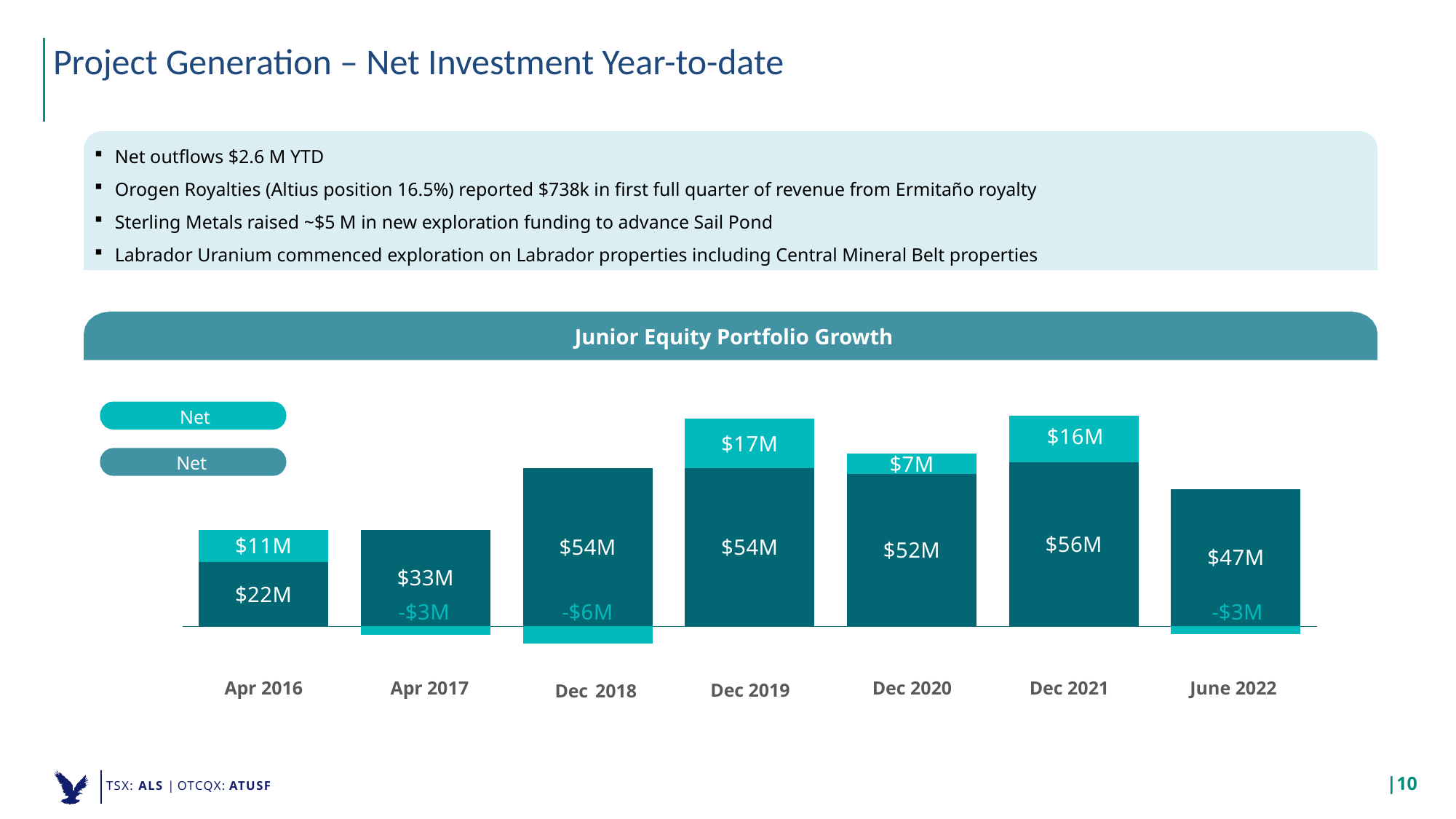
In the Junior Equity Portfolio Growth chart, what is the total of the two stacked segments for Dec 2019? $71M In the Junior Equity Portfolio Growth chart, is the light teal value larger for Dec 2019 or Dec 2021? Dec 2019 In the Junior Equity Portfolio Growth chart, what is the difference between the dark teal values for Dec 2021 and June 2022? $9M In the Junior Equity Portfolio Growth chart, what is the value of the light teal segment for Dec 2019? $17M In the Junior Equity Portfolio Growth chart, which period has the highest dark teal value? Dec 2021 How many series does the legend of the Junior Equity Portfolio Growth chart list? 2 In the Junior Equity Portfolio Growth chart, what is the value of the dark teal segment for Dec 2021? $56M What kind of chart is shown under the heading "Junior Equity Portfolio Growth"? Bar chart In the Junior Equity Portfolio Growth chart, which period has the lowest dark teal value? Apr 2016 In the Junior Equity Portfolio Growth chart, what is the value of the light teal segment for June 2022? -$3M In the Junior Equity Portfolio Growth chart, what is the value of the dark teal segment for Apr 2017? $33M How many time periods are shown along the x axis of the Junior Equity Portfolio Growth chart? 7